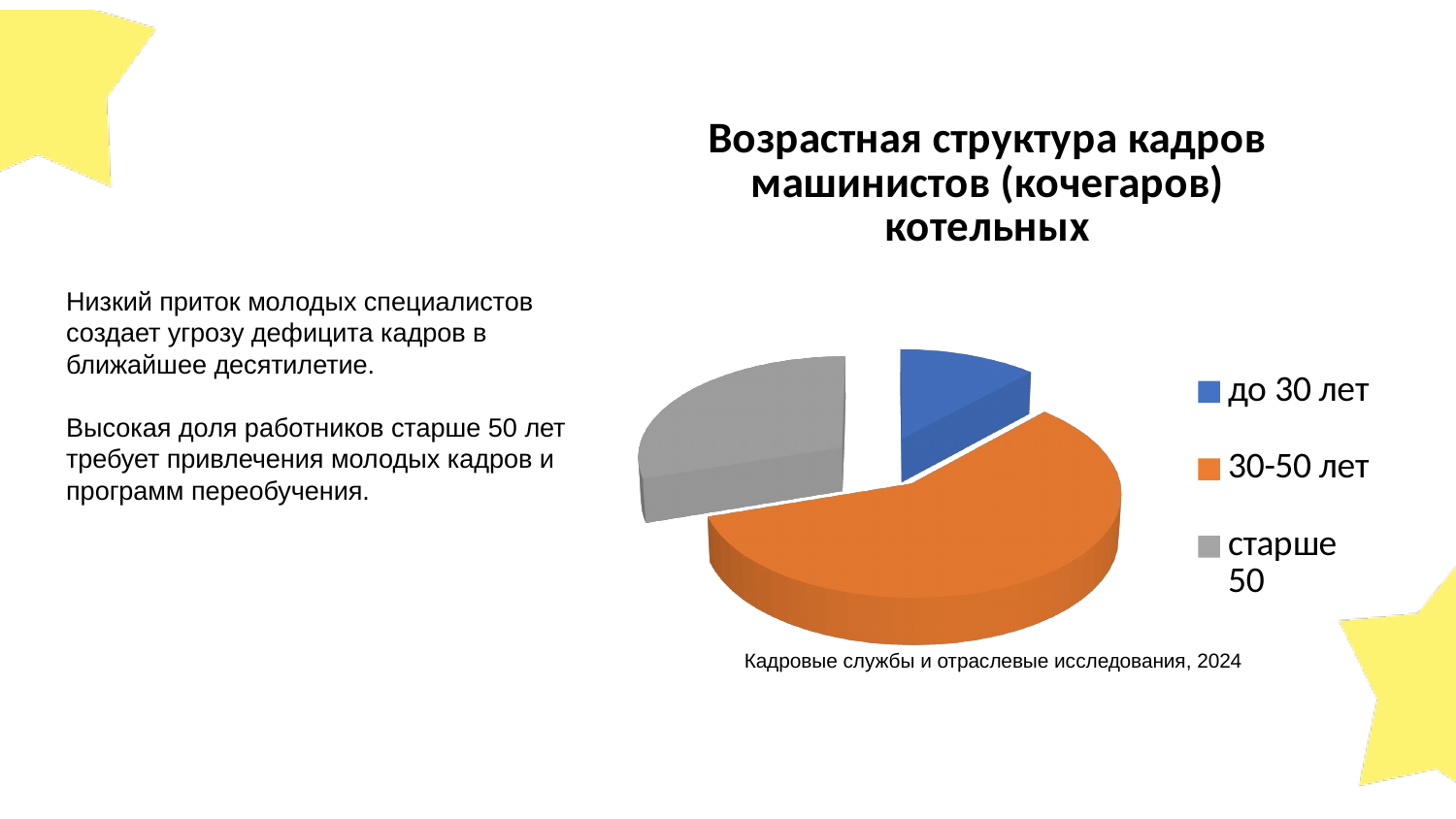
Which age group has the largest slice of the pie chart? 30-50 лет How many entries does the legend of the pie chart list? 3 Which age group has the smallest slice of the pie chart? до 30 лет What is the title of the pie chart? Возрастная структура кадров машинистов (кочегаров) котельных What kind of chart is shown on the slide? pie chart Which slice is larger: "30-50 лет" or "старше 50"? 30-50 лет How many slices does the pie chart have? 3 What colour is the slice for "30-50 лет" in the pie chart? orange Which slice is larger: "до 30 лет" or "старше 50"? старше 50